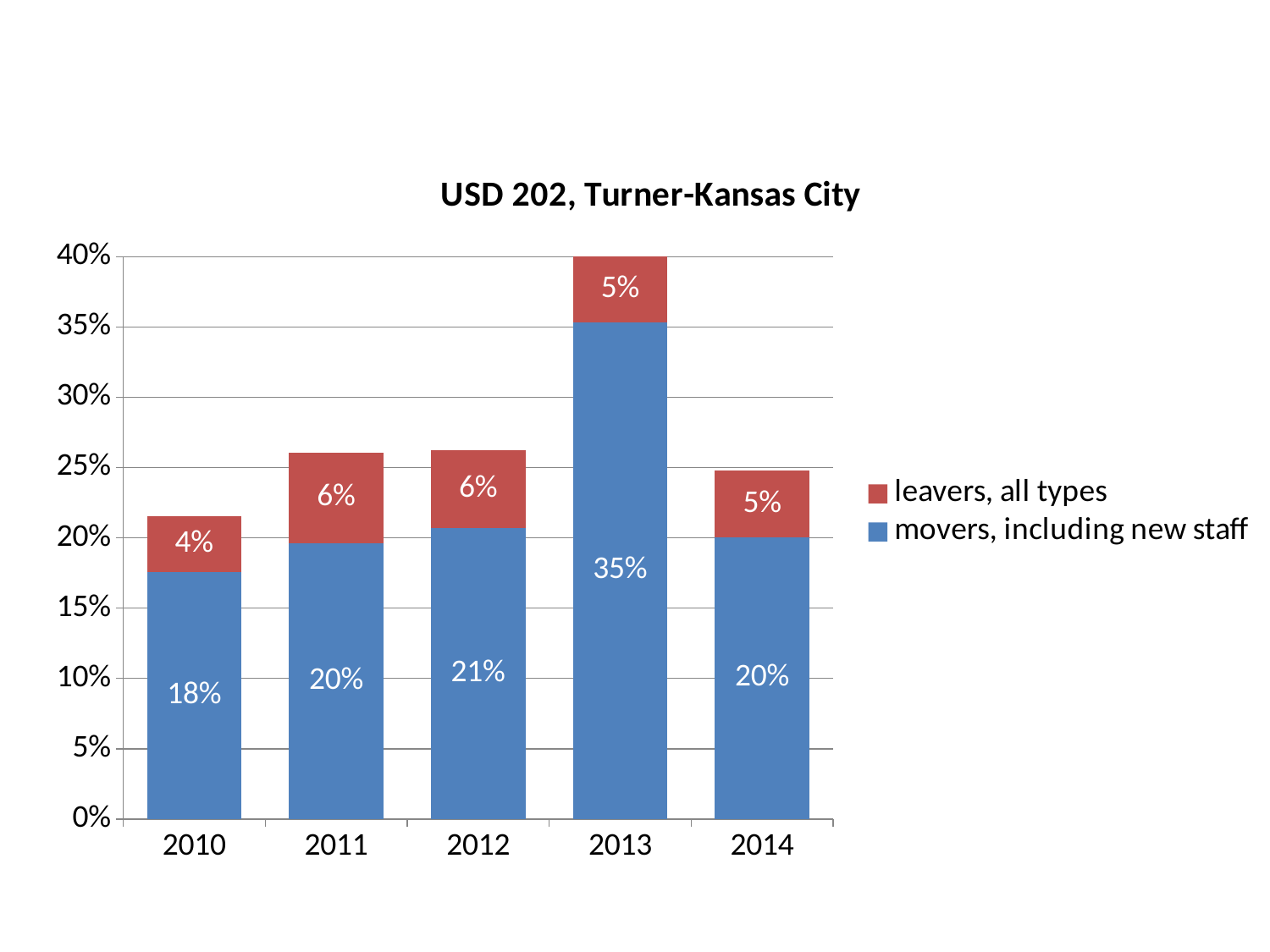
How many years are shown on the x axis? 5 What is the value for leavers, all types in 2010? 4% Which is larger: the leavers, all types value for 2011 or for 2014? 2011 Which year has the lowest value for movers, including new staff? 2010 Is the total height of the 2010 stacked bar greater or less than 25%? less What is the difference between the movers, including new staff values for 2013 and 2010? 17% What is the value for movers, including new staff in 2013? 35% What is the value for movers, including new staff in 2012? 21% What is the title of the chart? USD 202, Turner-Kansas City Which year has the highest value for movers, including new staff? 2013 Which year has the lowest value for leavers, all types? 2010 How many series does the legend list? 2